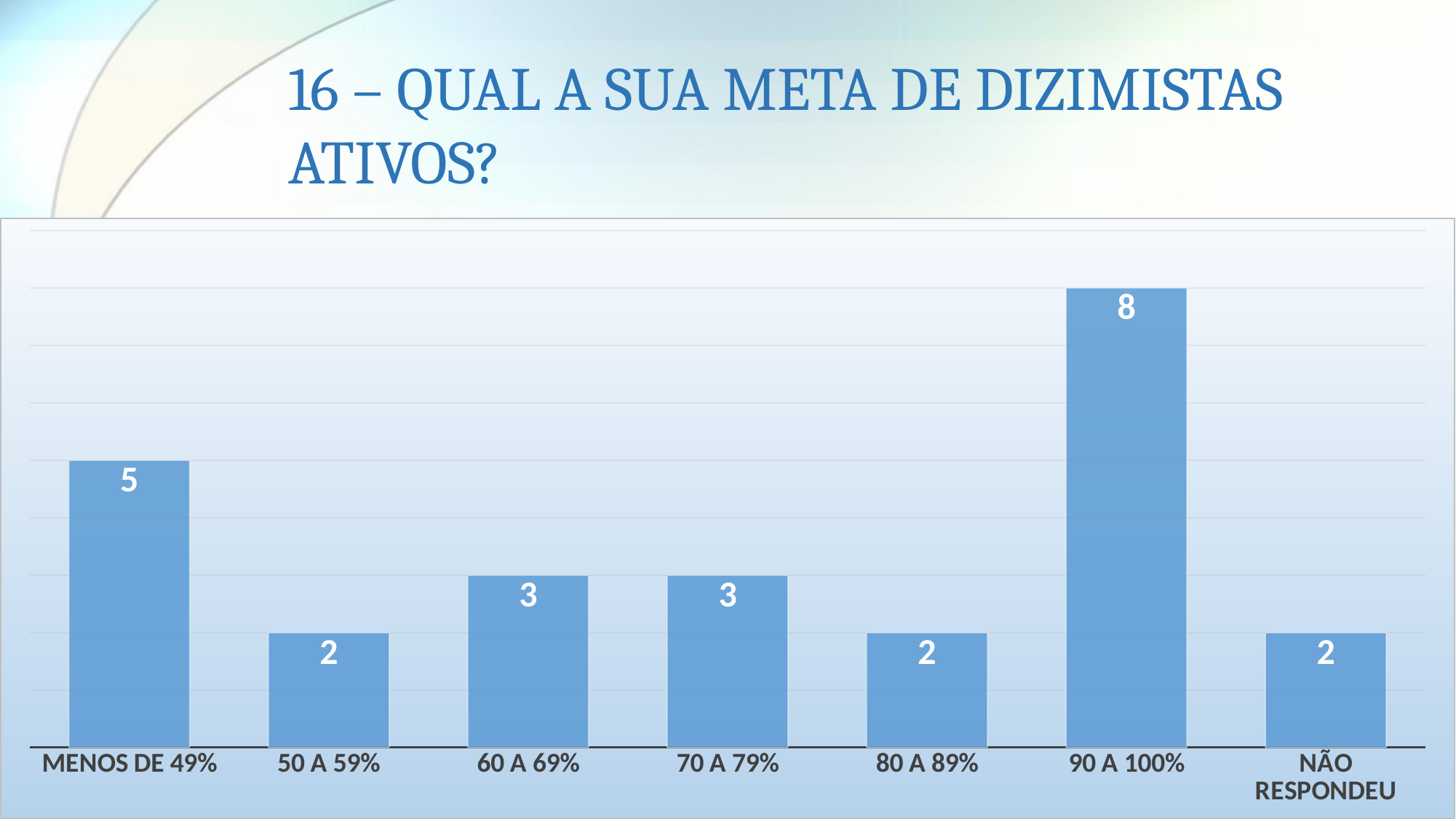
What is the value for the '90 A 100%' category? 8 What is the title of the slide? 16 – QUAL A SUA META DE DIZIMISTAS ATIVOS? What is the value for 'NÃO RESPONDEU'? 2 Which is larger, the value for 'MENOS DE 49%' or the value for '60 A 69%'? MENOS DE 49% What is the value for the 'MENOS DE 49%' category? 5 Which category has the highest value? 90 A 100% What is the difference between the values for '90 A 100%' and 'MENOS DE 49%'? 3 What is the difference between the values for '60 A 69%' and '80 A 89%'? 1 What is the value for the '70 A 79%' category? 3 What kind of chart is shown on the slide? Bar chart How many categories are shown on the x axis? 7 How many categories have a value of 2? 3